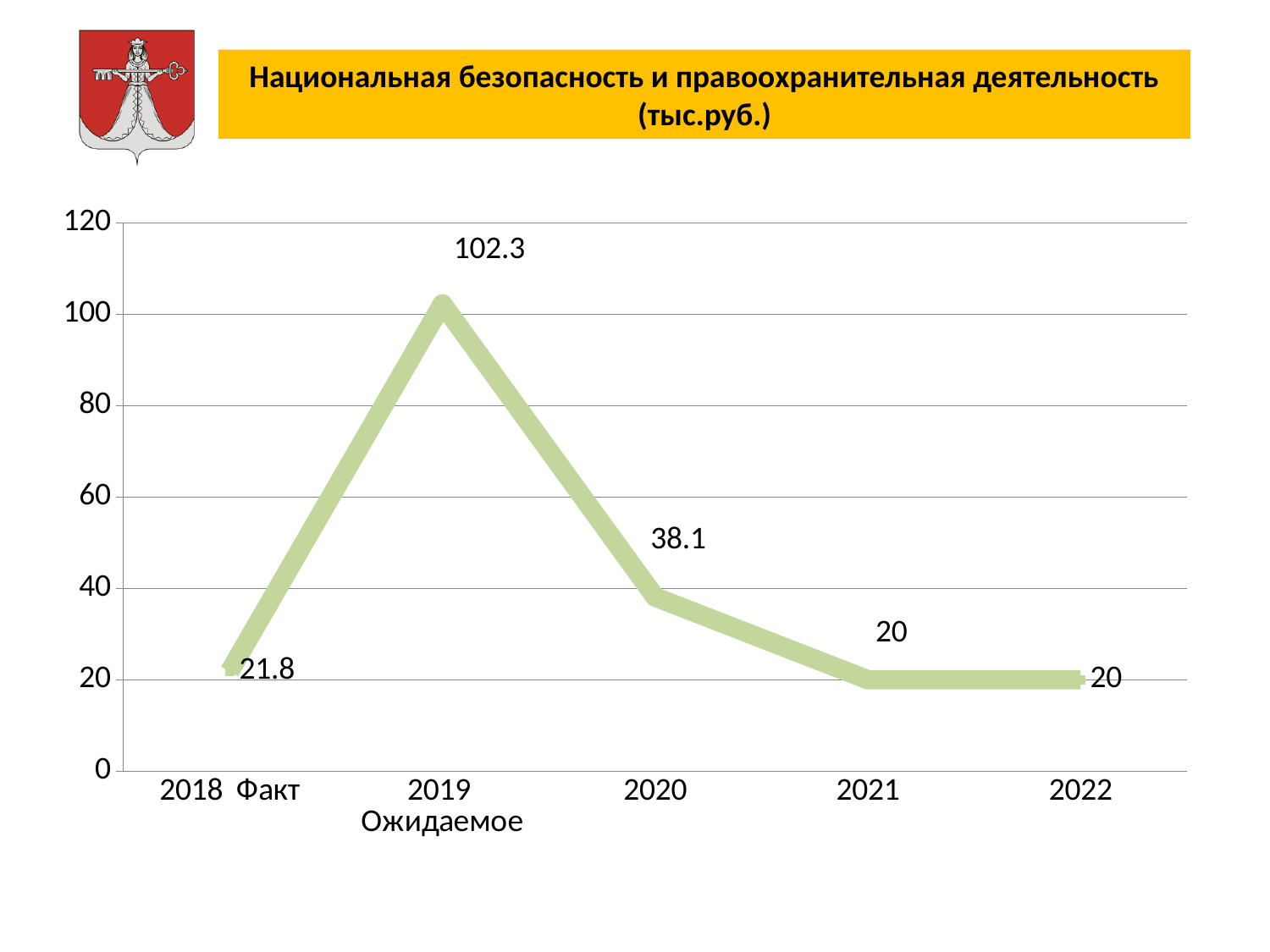
What is the value for 2020? 38.1 Which is larger, the value for 2018 Факт or the value for 2020? 2020 What is the difference between the values for 2019 Ожидаемое and 2020? 64.2 What kind of chart is shown on the slide? line chart What is the value for 2018 Факт? 21.8 Do the values rise or fall from 2019 Ожидаемое to 2021? fall What is the difference between the values for 2020 and 2021? 18.1 Is the value for 2019 Ожидаемое greater or less than 100? greater Which year has the highest value? 2019 Ожидаемое What is the value for 2019 Ожидаемое? 102.3 How many data points are plotted on the chart? 5 What is the value for 2022? 20